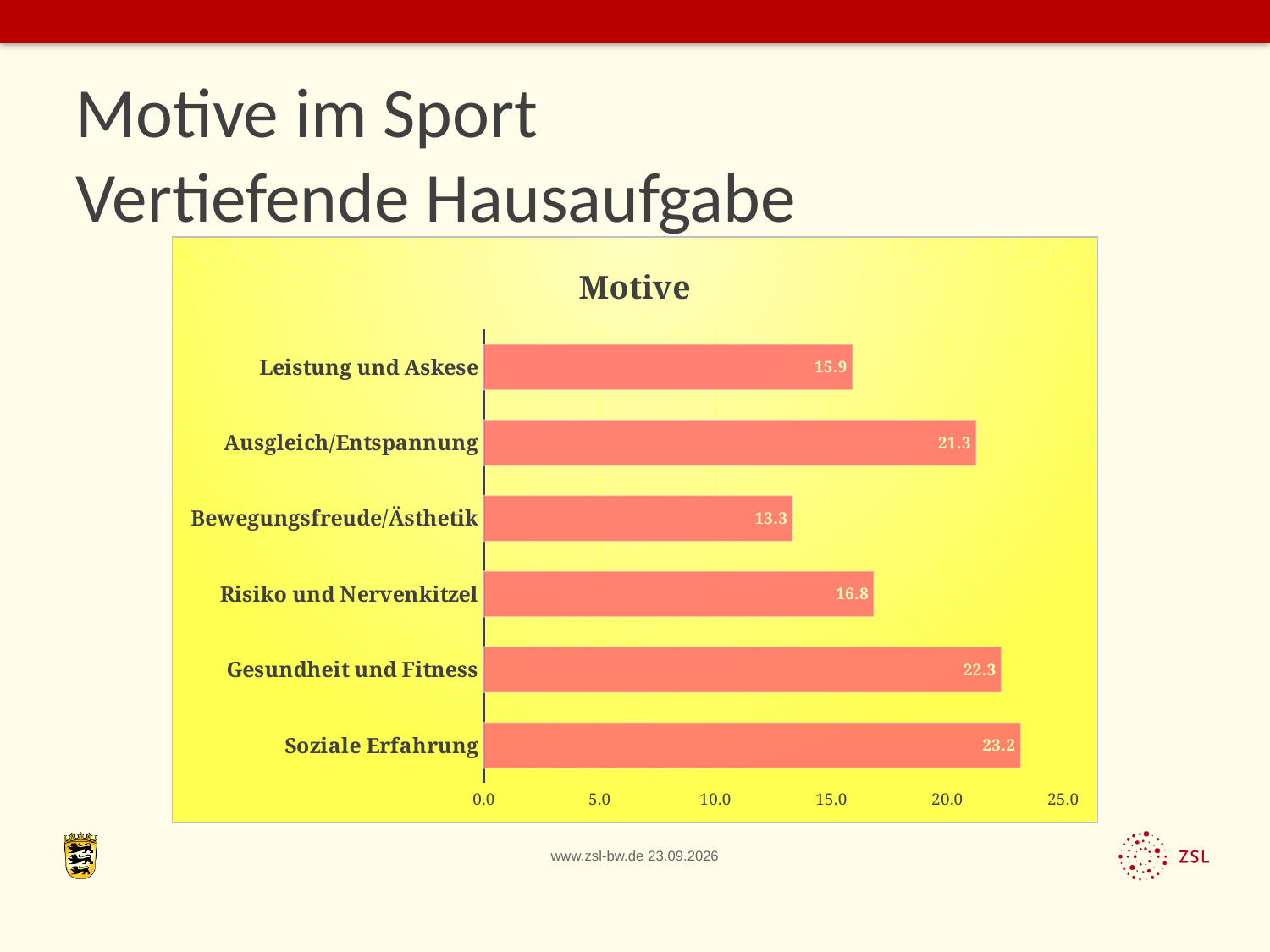
What is the value for Gesundheit und Fitness? 22.3 What is the value for Bewegungsfreude/Ästhetik? 13.3 Which category has the highest value? Soziale Erfahrung What is the value for Leistung und Askese? 15.9 What is the difference between the values for Soziale Erfahrung and Risiko und Nervenkitzel? 6.4 What is the value for Ausgleich/Entspannung? 21.3 Is the value for Risiko und Nervenkitzel greater or less than 20.0? less How many categories are shown in the chart? 6 What is the title of the chart? Motive Which category has the lowest value? Bewegungsfreude/Ästhetik What kind of chart is shown on the slide? bar chart Which is larger, the value for Ausgleich/Entspannung or the value for Leistung und Askese? Ausgleich/Entspannung